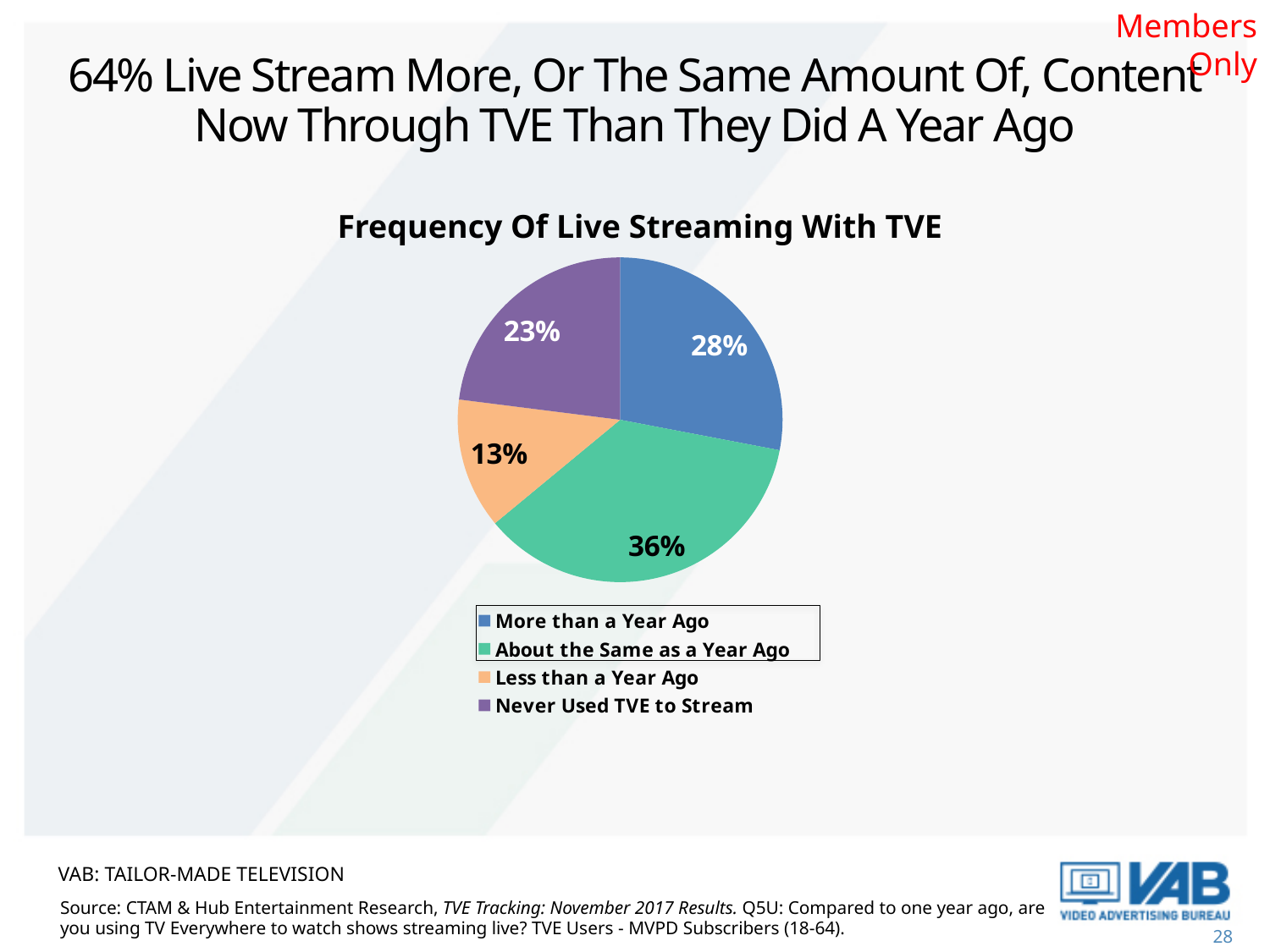
Which is larger: the share for 'Never Used TVE to Stream' or 'Less than a Year Ago'? Never Used TVE to Stream What type of chart is shown on the slide? pie chart What is the difference between the share for 'About the Same as a Year Ago' and 'More than a Year Ago'? 8% Which category has the smallest share of the pie? Less than a Year Ago What is the combined share of 'More than a Year Ago' and 'About the Same as a Year Ago'? 64% What percentage of respondents live stream less than a year ago? 13% What percentage of respondents live stream about the same as a year ago? 36% What is the title of the chart? Frequency Of Live Streaming With TVE How many categories does the pie chart show? 4 What percentage of respondents have never used TVE to stream? 23% What percentage of respondents live stream more than a year ago? 28% Which category has the largest share of the pie? About the Same as a Year Ago